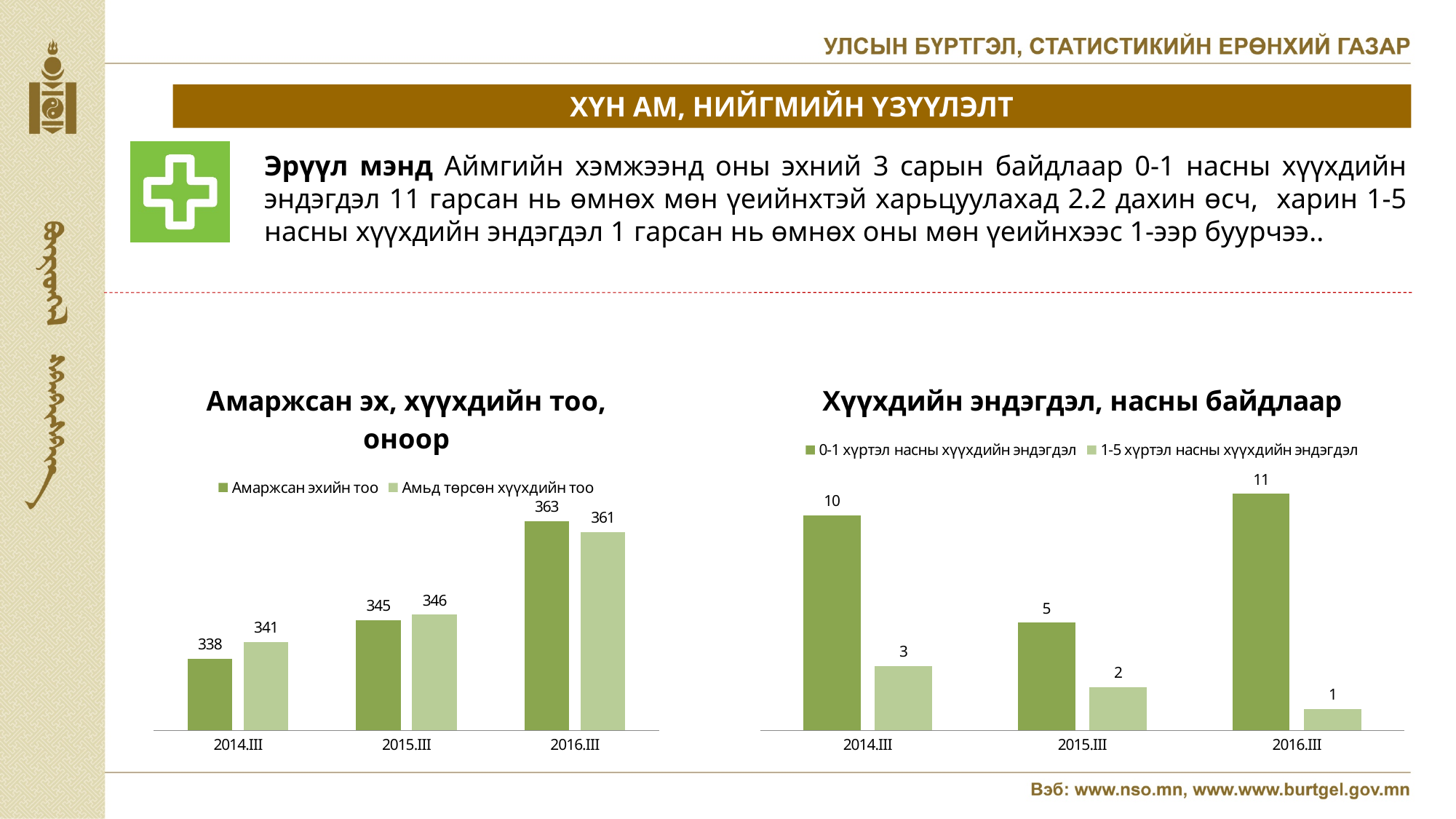
In the chart 'Амаржсан эх, хүүхдийн тоо, оноор', what is the value of 'Амьд төрсөн хүүхдийн тоо' for 2016.III? 361 In the chart 'Амаржсан эх, хүүхдийн тоо, оноор', how many series does the legend list? 2 In the chart 'Хүүхдийн эндэгдэл, насны байдлаар', which period has the lowest value for '0-1 хүртэл насны хүүхдийн эндэгдэл'? 2015.III In the chart 'Хүүхдийн эндэгдэл, насны байдлаар', what is the value of '0-1 хүртэл насны хүүхдийн эндэгдэл' for 2016.III? 11 In the chart 'Хүүхдийн эндэгдэл, насны байдлаар', what is the value of '1-5 хүртэл насны хүүхдийн эндэгдэл' for 2014.III? 3 What type of chart is 'Хүүхдийн эндэгдэл, насны байдлаар'? bar chart In the chart 'Хүүхдийн эндэгдэл, насны байдлаар', how many periods are shown on the x axis? 3 In the chart 'Амаржсан эх, хүүхдийн тоо, оноор', what is the difference between 'Амьд төрсөн хүүхдийн тоо' in 2016.III and 2014.III? 20 In the chart 'Хүүхдийн эндэгдэл, насны байдлаар', what is the difference between the two series in 2016.III? 10 In the chart 'Амаржсан эх, хүүхдийн тоо, оноор', what is the value of 'Амаржсан эхийн тоо' for 2014.III? 338 In the chart 'Амаржсан эх, хүүхдийн тоо, оноор', which period has the highest value for 'Амаржсан эхийн тоо'? 2016.III In the chart 'Амаржсан эх, хүүхдийн тоо, оноор', does 'Амаржсан эхийн тоо' rise or fall from 2014.III to 2016.III? rise